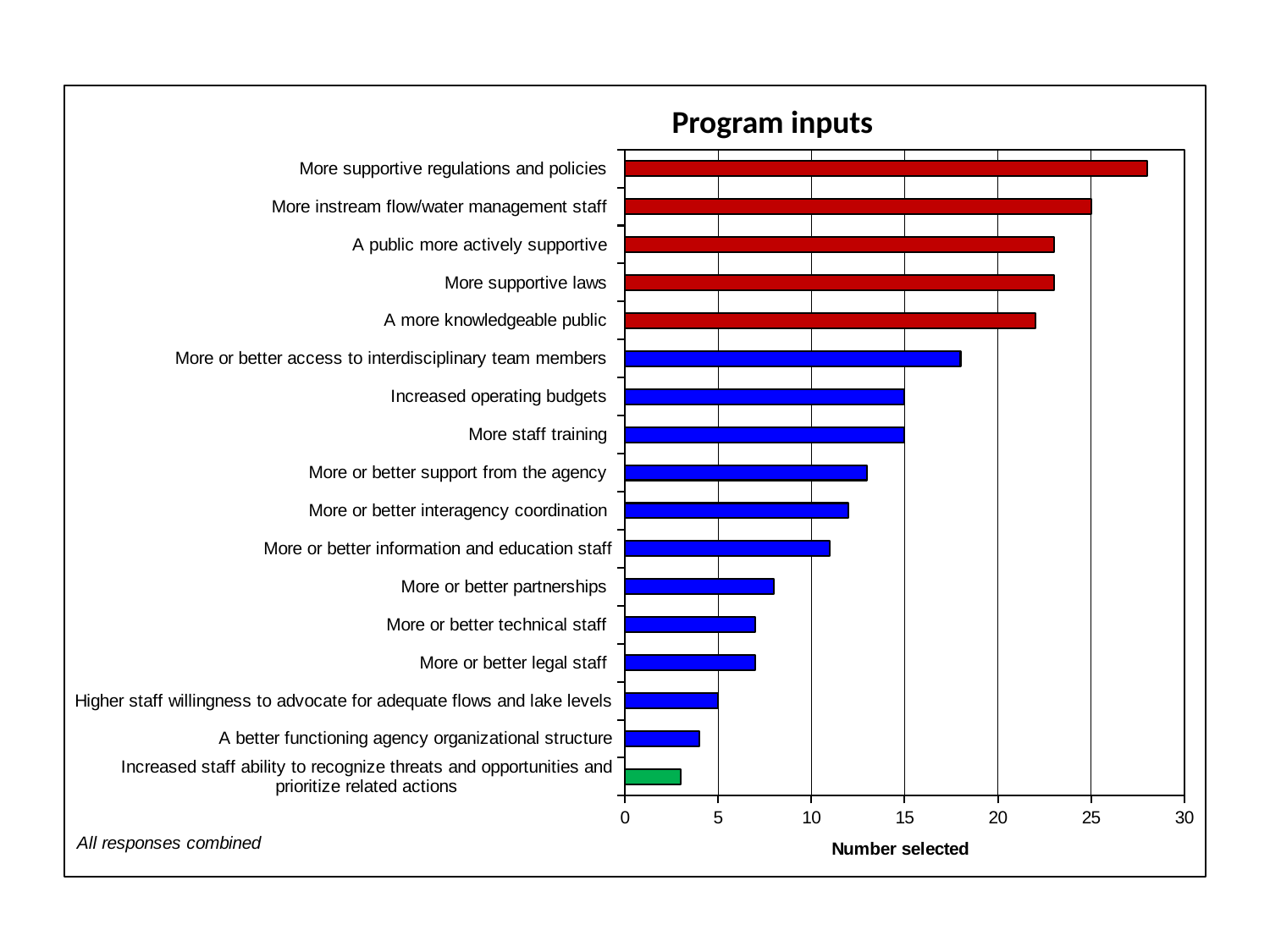
What is the number selected for 'Increased operating budgets'? 15 Which category has the lowest number selected? Increased staff ability to recognize threats and opportunities and prioritize related actions What is the title of the chart? Program inputs Is the value for 'A better functioning agency organizational structure' greater or less than 5? less What is the number selected for 'More instream flow/water management staff'? 25 Which has a larger number selected: 'A more knowledgeable public' or 'Increased operating budgets'? A more knowledgeable public What is the label of the horizontal axis? Number selected How many categories are plotted in the chart? 17 What kind of chart is shown on the slide? bar chart What is the number selected for 'Higher staff willingness to advocate for adequate flows and lake levels'? 5 Is the value for 'More supportive regulations and policies' greater or less than 25? greater Which category has the highest number selected? More supportive regulations and policies